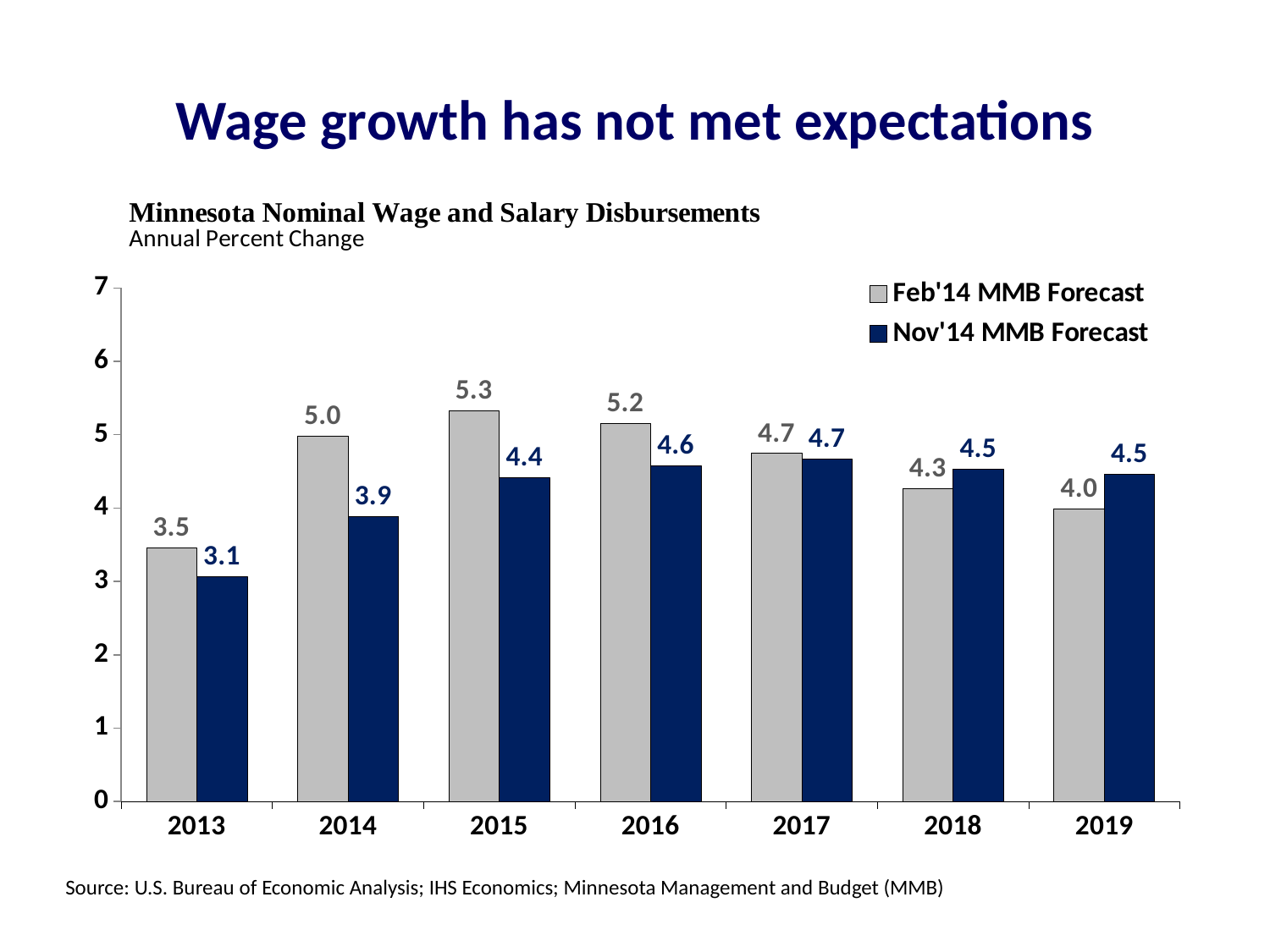
Which year has the lowest Nov'14 MMB Forecast value? 2013 What is the Nov'14 MMB Forecast value for 2016? 4.6 What kind of chart is shown on the slide? Bar chart What is the Nov'14 MMB Forecast value for 2013? 3.1 Does the Nov'14 MMB Forecast rise or fall from 2013 to 2016? Rise What is the Feb'14 MMB Forecast value for 2015? 5.3 How many series does the legend list? 2 What is the chart's title? Minnesota Nominal Wage and Salary Disbursements What is the difference between the Feb'14 MMB Forecast and the Nov'14 MMB Forecast for 2014? 1.1 Which year has the highest Feb'14 MMB Forecast value? 2015 How many years are shown on the x axis? 7 Which is larger for 2019, the Feb'14 MMB Forecast or the Nov'14 MMB Forecast? Nov'14 MMB Forecast